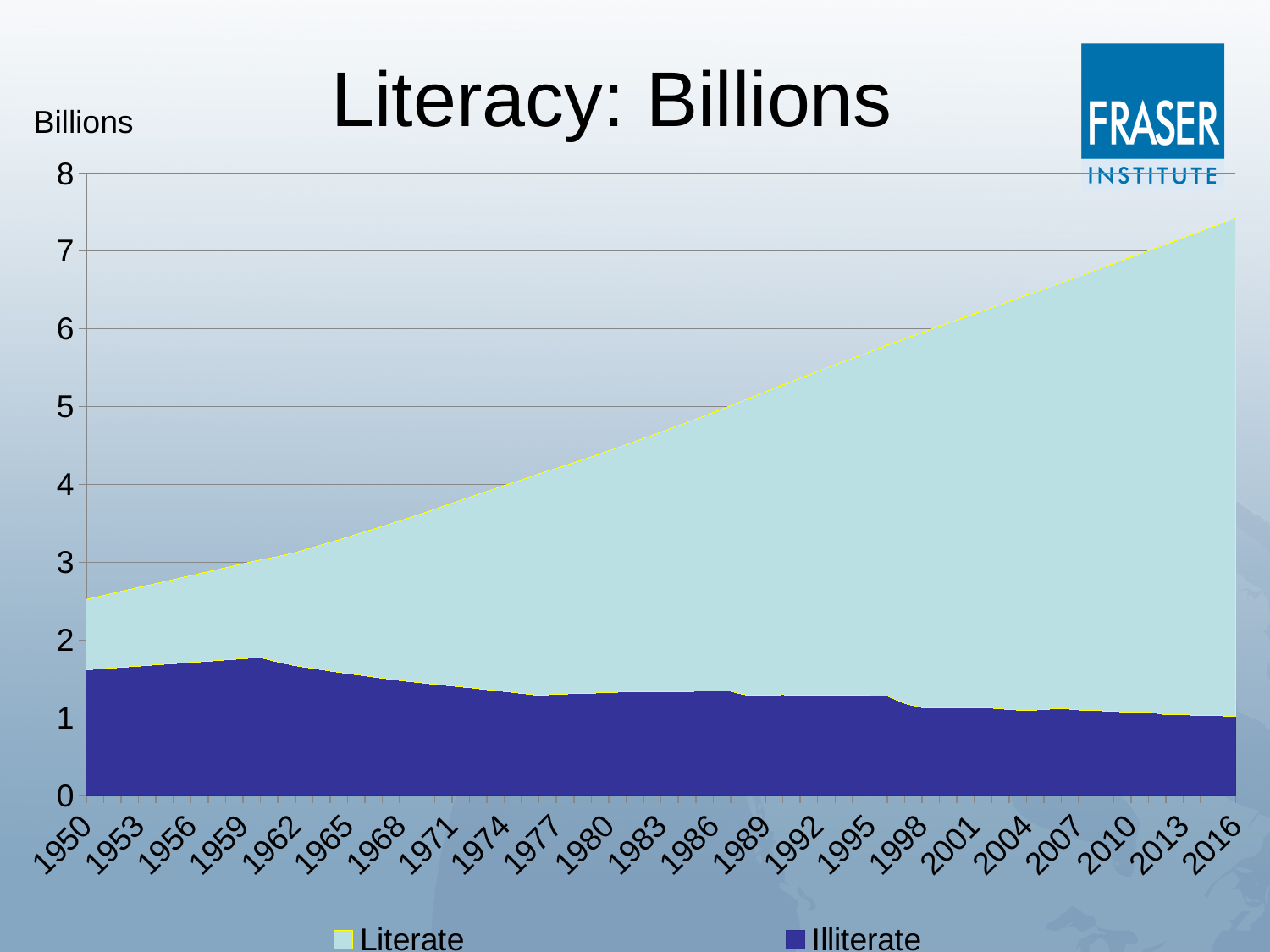
Is the total stacked value in 1980 greater or less than 4? greater Is the Illiterate value in 1950 greater or less than 1? greater Is the total stacked value in 2016 greater or less than 7? greater How many series does the legend list? 2 What is the title of the chart? Literacy: Billions What are the two series named in the legend? Literate and Illiterate Does the total (Literate plus Illiterate) rise or fall from 1950 to 2016? Rise What kind of chart is shown on the slide? Stacked area chart How many year labels are shown on the x axis? 23 Which is larger, the Illiterate value in 1950 or the Illiterate value in 2016? 1950